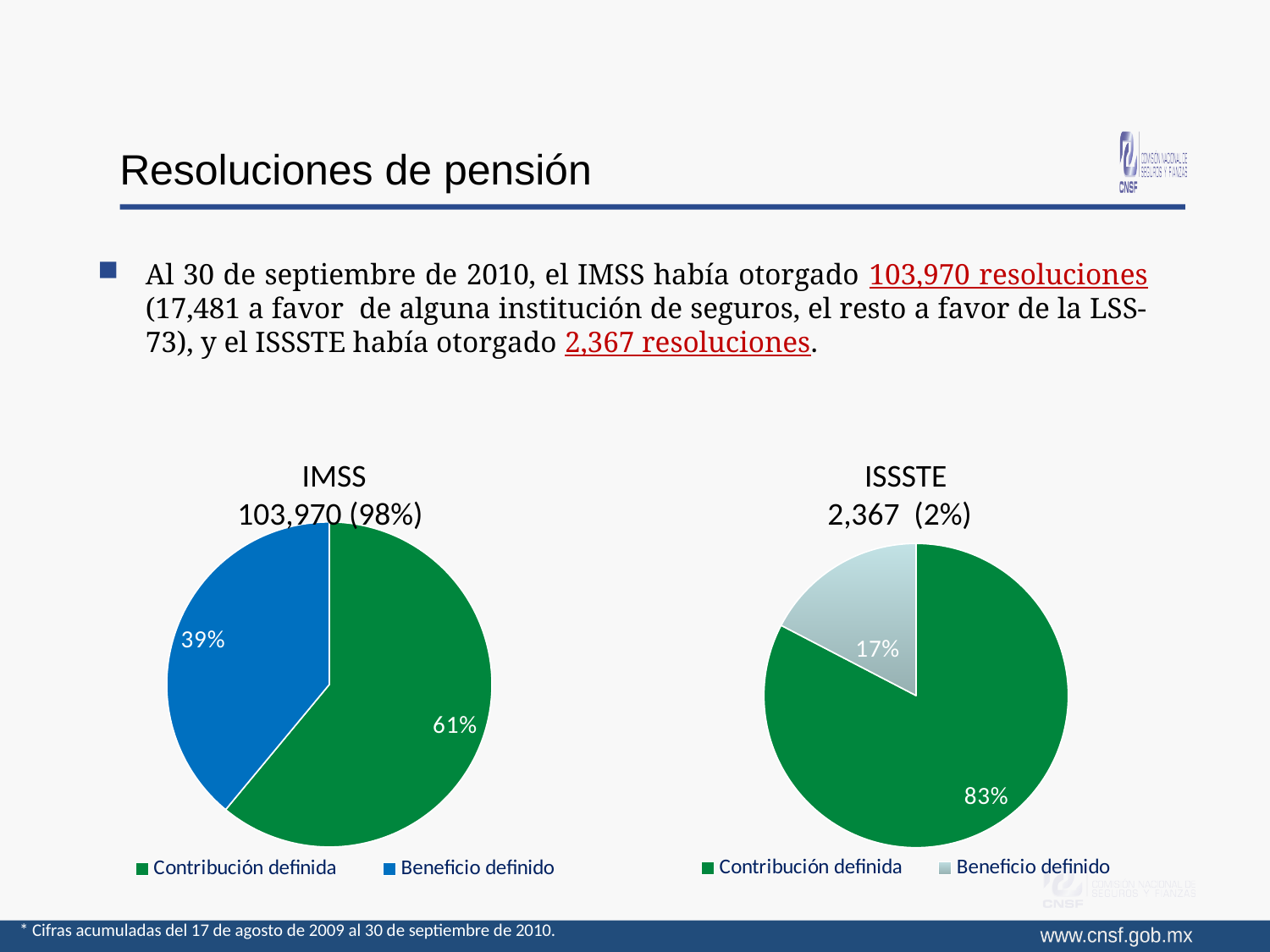
What type of chart is used for the IMSS data? Pie chart In the IMSS pie chart, which category has the largest slice? Contribución definida In the IMSS pie chart, what is the difference in percentage points between Contribución definida and Beneficio definido? 22 Which chart has the larger share for Beneficio definido, IMSS or ISSSTE? IMSS In the ISSSTE pie chart, which category has the smallest slice? Beneficio definido What total number of resolutions is shown in the title of the ISSSTE chart? 2,367 (2%) In the ISSSTE pie chart, what share does Contribución definida have? 83% In the IMSS pie chart, what share does Contribución definida have? 61% How many categories does the legend of the ISSSTE chart list? 2 In the ISSSTE pie chart, what is the difference in percentage points between Contribución definida and Beneficio definido? 66 In the ISSSTE pie chart, what share does Beneficio definido have? 17% In the IMSS pie chart, what share does Beneficio definido have? 39%